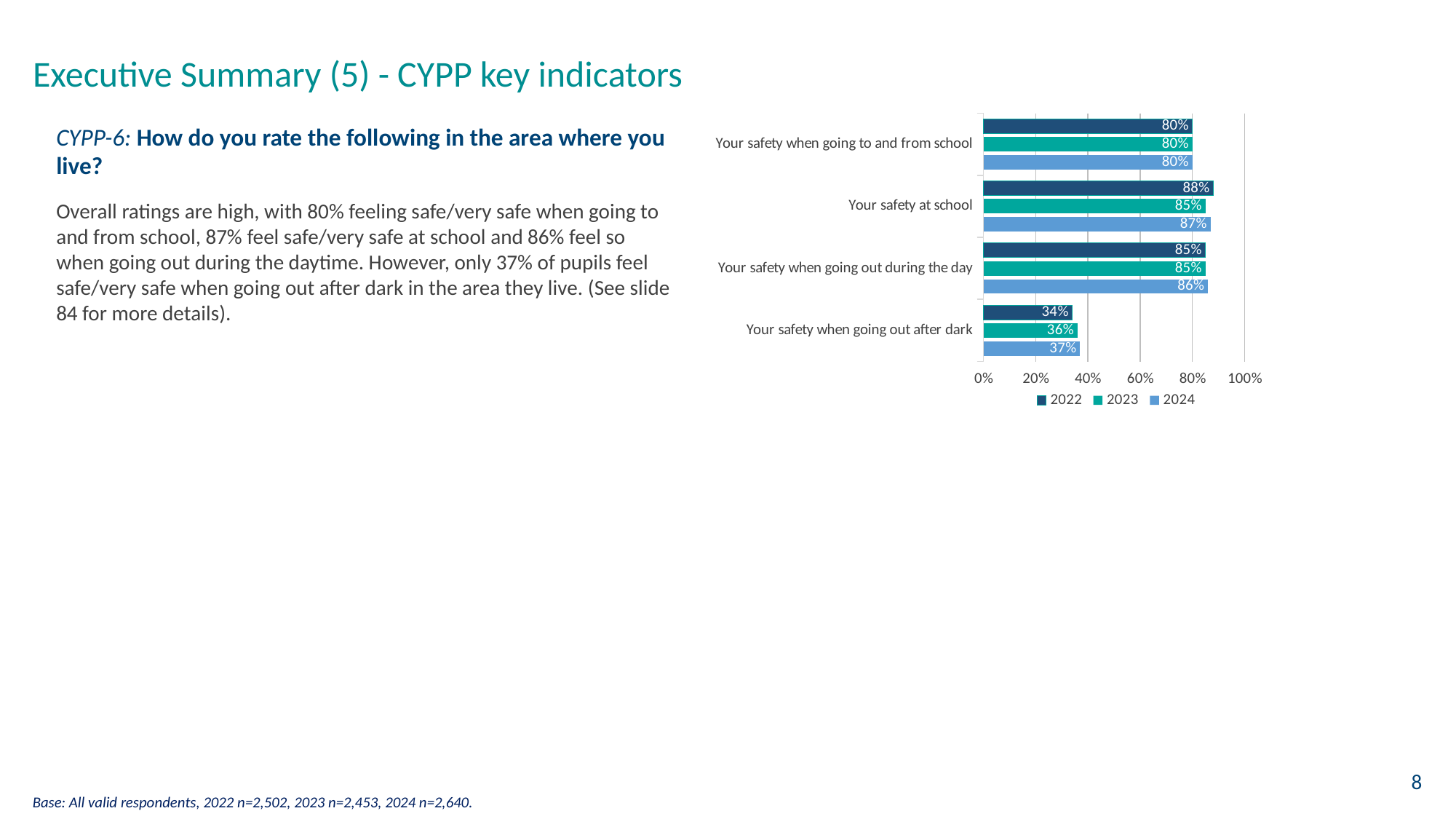
How many series does the legend list? 3 What is the 2023 value for 'Your safety when going out during the day'? 85% Which years are listed in the chart legend? 2022, 2023, 2024 Which category has the highest 2022 value? Your safety at school What is the difference between the 2024 and 2022 values for 'Your safety when going out after dark'? 3 percentage points Which is larger: the 2024 value for 'Your safety at school' or the 2024 value for 'Your safety when going to and from school'? Your safety at school Is the 2023 value for 'Your safety when going out after dark' greater or less than 40%? less Which category has the lowest 2024 value? Your safety when going out after dark What kind of chart is shown on the slide? Bar chart What is the 2022 value for 'Your safety at school'? 88% What is the 2024 value for 'Your safety when going out after dark'? 37% How many categories are shown on the chart? 4